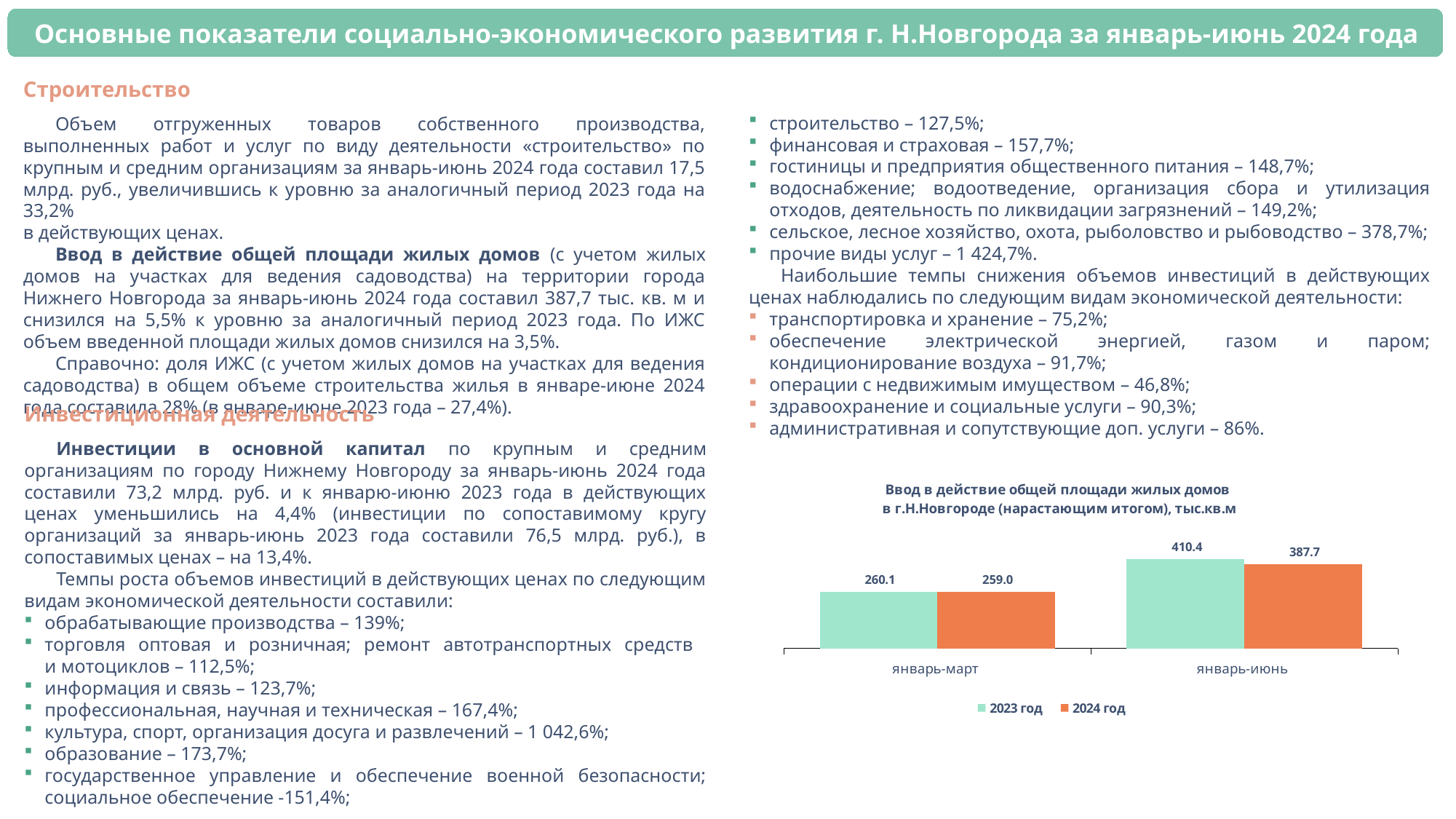
What is the value for 2023 год in январь-июнь? 410.4 How many series does the chart legend list? 2 What is the title of the chart? Ввод в действие общей площади жилых домов в г.Н.Новгороде (нарастающим итогом), тыс.кв.м Which bar has the highest value on the chart? 2023 год, январь-июнь What is the difference between the 2023 год and 2024 год values for январь-март? 1.1 What is the value for 2024 год in январь-март? 259.0 How many categories are shown on the x axis of the chart? 2 What is the difference between the 2023 год and 2024 год values for январь-июнь? 22.7 For январь-июнь, which series has the larger value, 2023 год or 2024 год? 2023 год What kind of chart is shown on the slide? bar chart What is the value for 2024 год in январь-июнь? 387.7 What is the value for 2023 год in январь-март? 260.1